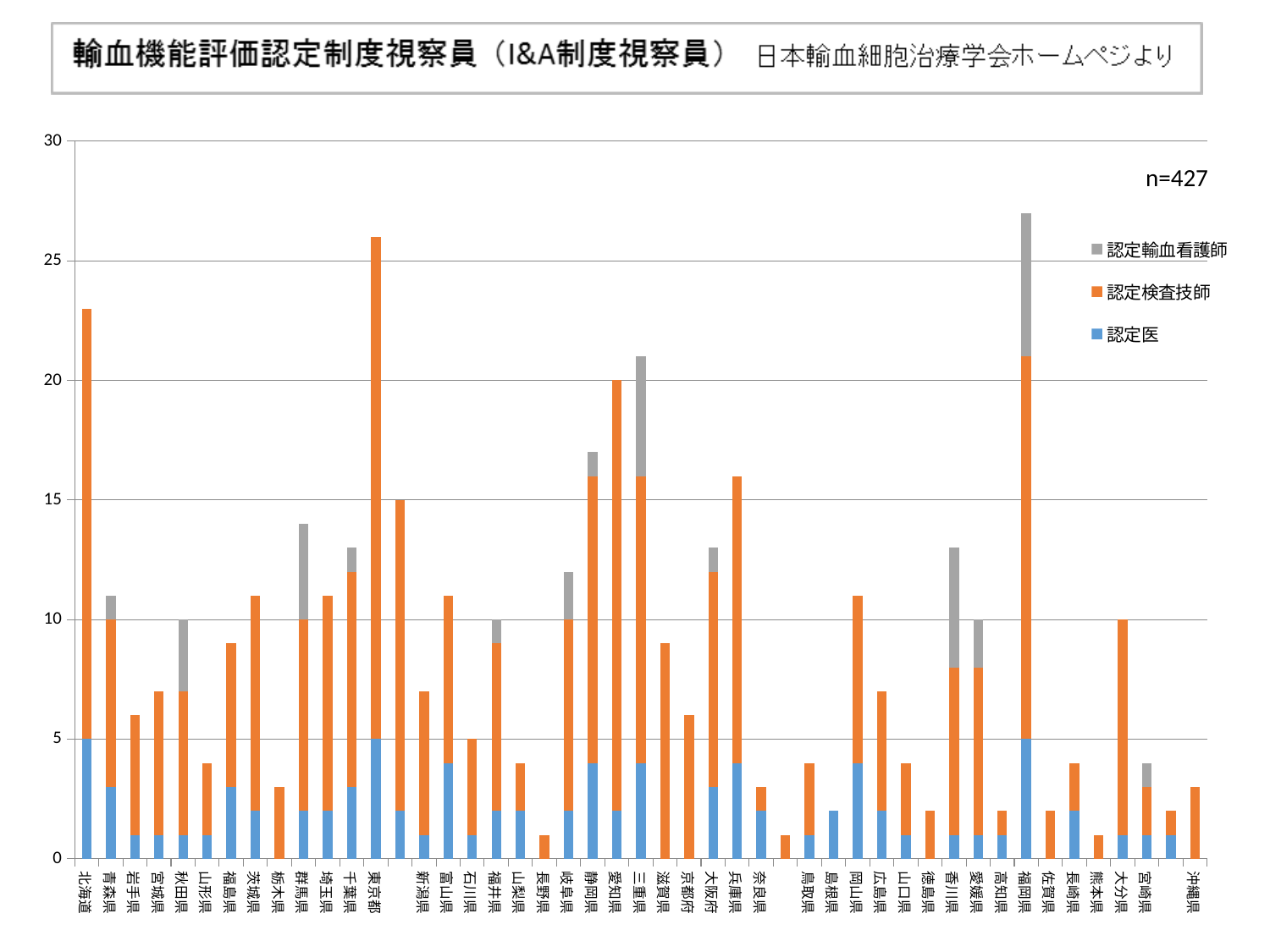
Which has the larger total, 北海道 or 青森県? 北海道 What is the 認定医 value for 北海道? 5 Which has the larger total, 東京都 or 北海道? 東京都 Is the total value for 福岡県 greater or less than 25? greater Is the total value for 長野県 greater or less than 5? less Is the total value for 北海道 greater or less than 20? greater What kind of chart is shown on the slide? bar chart What sample size (n) is printed on the chart? n=427 What are the three series listed in the legend? 認定輸血看護師, 認定検査技師, 認定医 How many series does the legend list? 3 What is the total value of the bar for 愛知県? 20 What is the total value of the bar for 大分県? 10